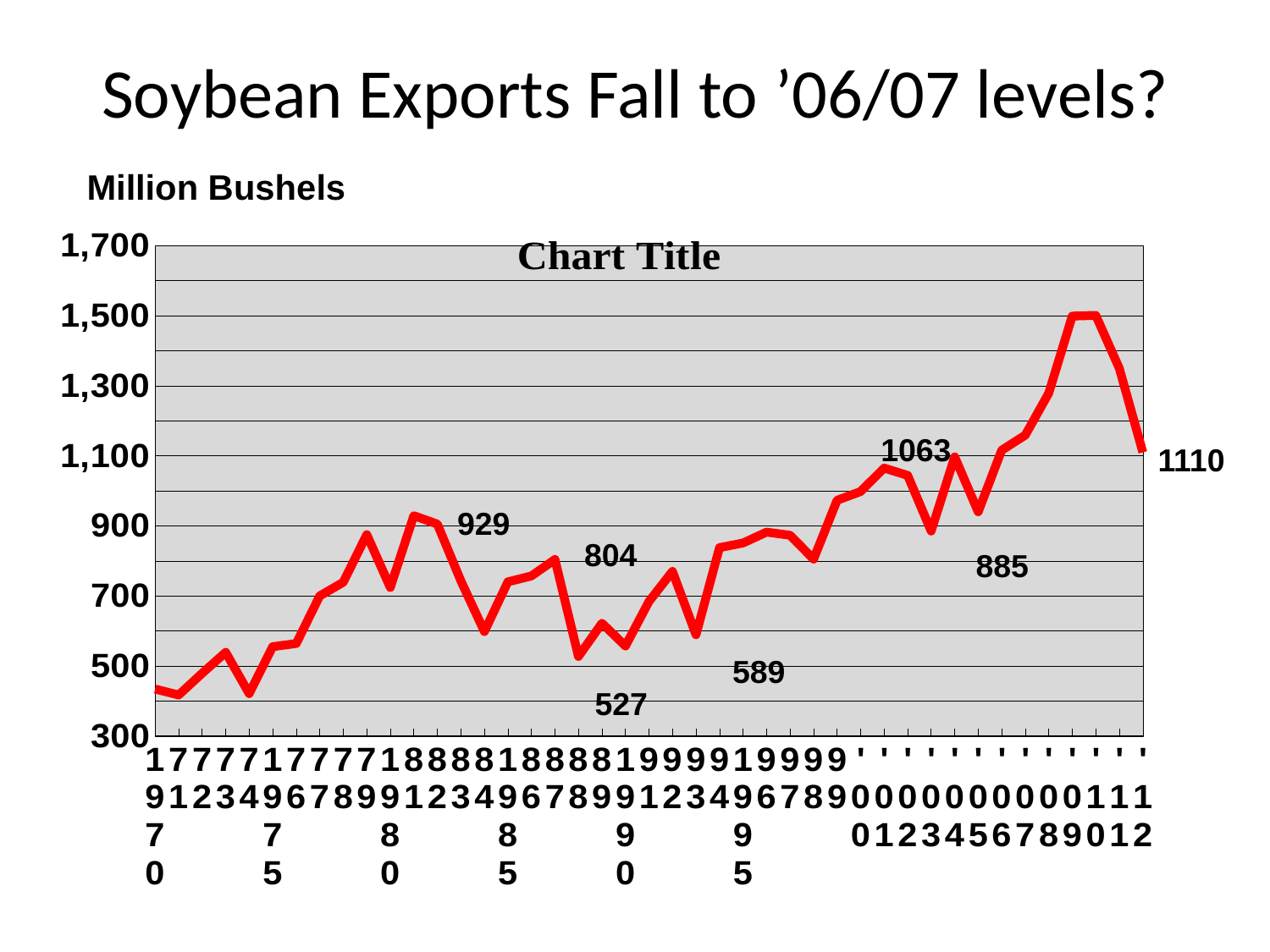
What unit is given for the values on the chart? Million Bushels Overall, do the values rise or fall from 1970 to 2010? rise Which is larger, the data label 929 or the data label 804? 929 What is the lowest value printed as a data label on the chart? 527 What is the difference between the data labels 1063 and 589? 474 What is the highest value printed as a data label on the chart? 1110 Is the peak value around 2010 greater or less than 1,300? greater What kind of chart is shown on the slide? line chart What is the difference between the data labels 1110 and 885? 225 Is the value for 1970 greater or less than 500? less What value is labeled at the final point of the line (2012)? 1110 What is the title printed inside the chart area? Chart Title